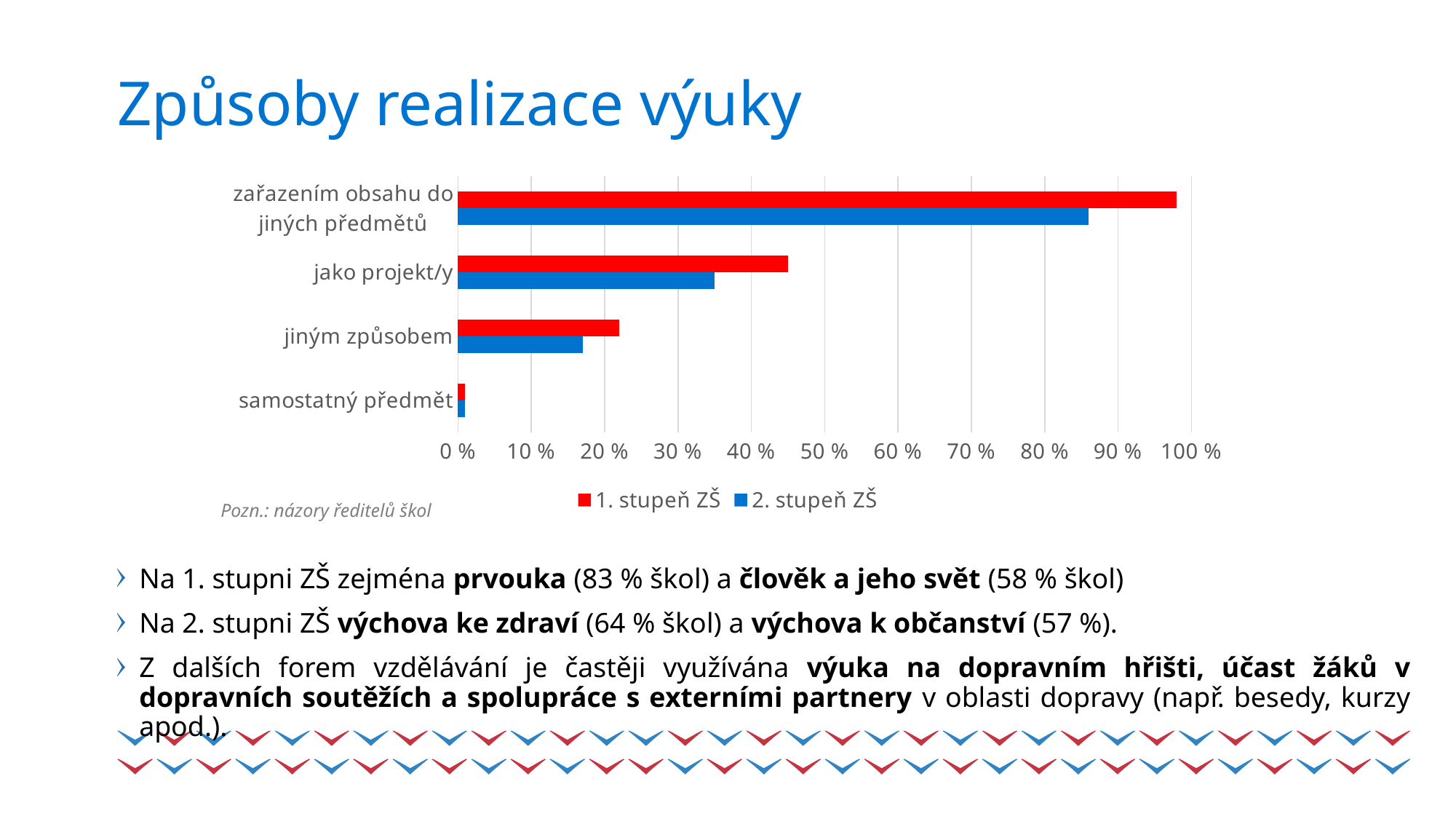
Is the value for 2. stupeň ZŠ in the category 'jiným způsobem' greater or less than 20 %? less Which colour represents the series 2. stupeň ZŠ in the chart? blue Is the value for 1. stupeň ZŠ in the category 'jako projekt/y' greater or less than 40 %? greater What note is printed below the chart on the left? Pozn.: názory ředitelů škol Which category has the lowest value for 2. stupeň ZŠ? samostatný předmět For the category 'jako projekt/y', which series has the larger value, 1. stupeň ZŠ or 2. stupeň ZŠ? 1. stupeň ZŠ Which category has the highest value for 1. stupeň ZŠ? zařazením obsahu do jiných předmětů What kind of chart is shown on the slide? bar chart How many series does the chart legend list? 2 Is the value for 2. stupeň ZŠ in the category 'zařazením obsahu do jiných předmětů' greater or less than 90 %? less How many categories are shown on the chart? 4